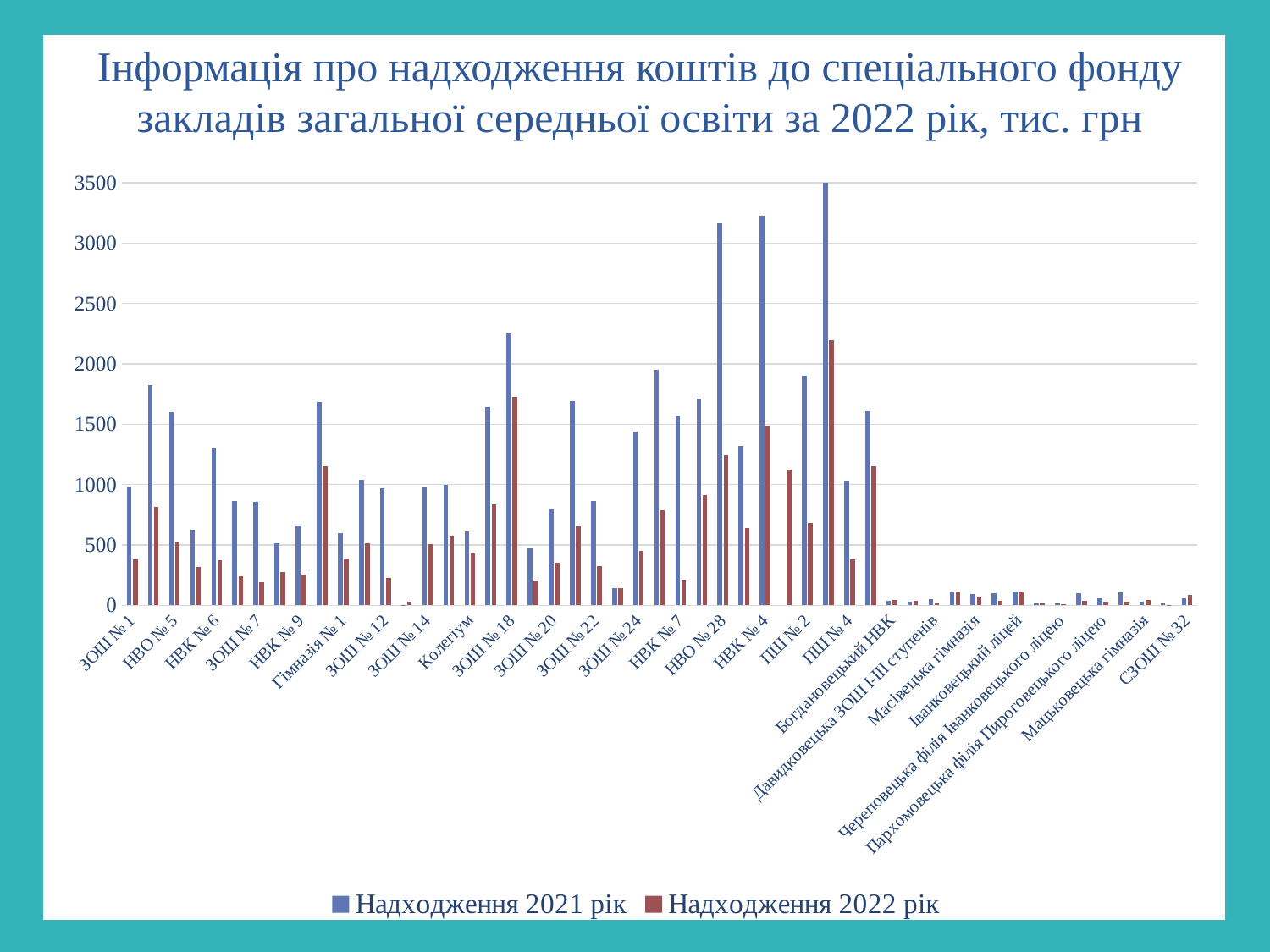
For ЗОШ № 1, which series has the larger value, Надходження 2021 рік or Надходження 2022 рік? Надходження 2021 рік Is the value for Мацьковецька гімназія in the Надходження 2021 рік series greater or less than 500? less How many series does the legend list? 2 Is the tallest bar in the Надходження 2022 рік series greater or less than 2500? less Which has the larger Надходження 2021 рік value, ЗОШ № 1 or Мацьковецька гімназія? ЗОШ № 1 Is the value for ЗОШ № 1 in the Надходження 2021 рік series greater or less than 500? greater What are the two series named in the legend? Надходження 2021 рік and Надходження 2022 рік What is the highest value shown on the vertical axis? 3500 What kind of chart is shown on the slide? bar chart